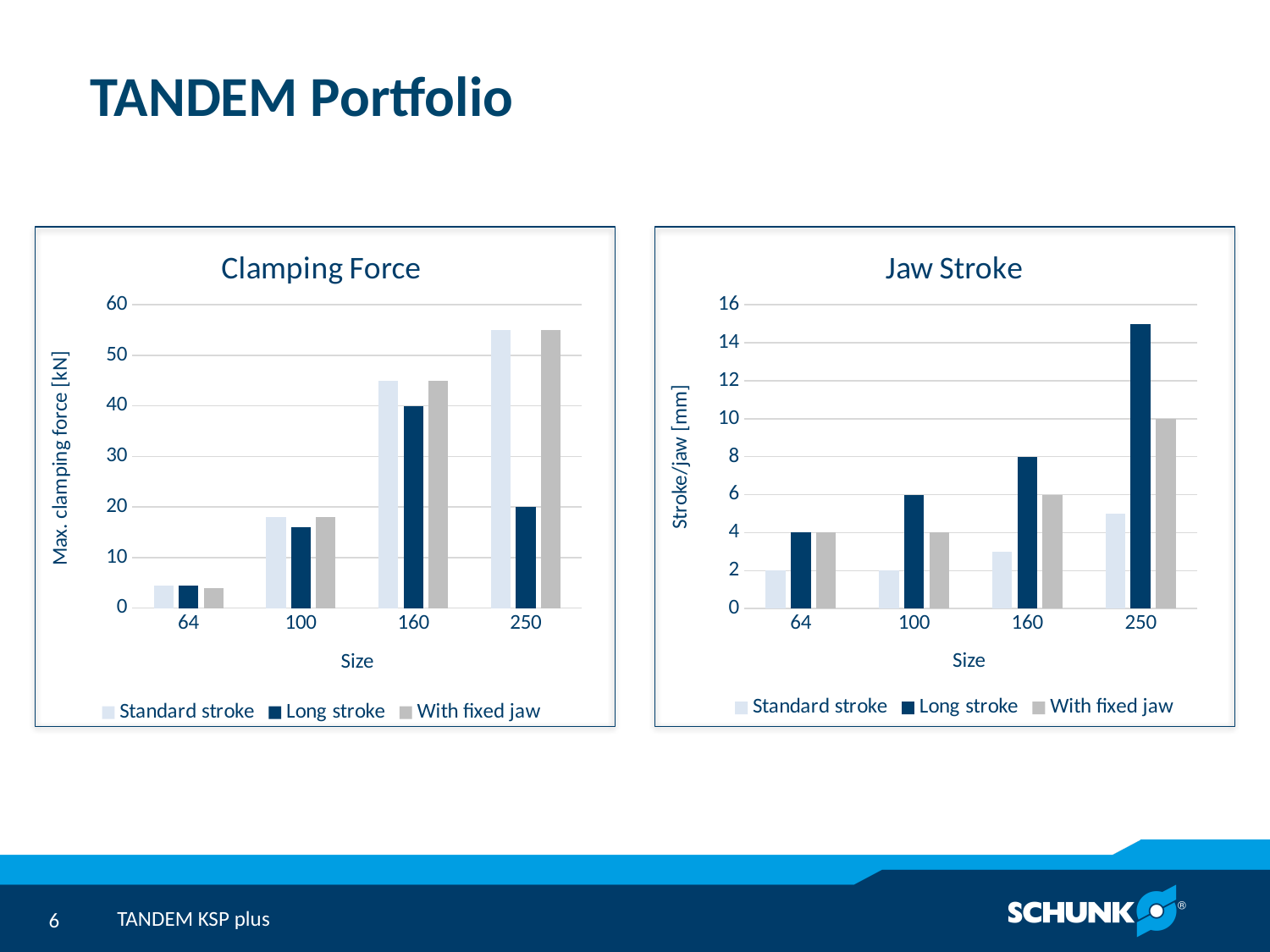
On the Clamping Force chart, for size 250, which is larger: Standard stroke or Long stroke? Standard stroke On the Clamping Force chart, what kind of chart is shown? bar chart On the Clamping Force chart, which size has the lowest With fixed jaw value? 64 On the Clamping Force chart, is the Long stroke value for size 250 greater or less than 30? less On the Clamping Force chart, is the Standard stroke value for size 250 greater or less than 50? greater On the Clamping Force chart, do the Standard stroke values rise or fall as size increases from 64 to 250? rise On the Jaw Stroke chart, how many series does the legend list? 3 On the Jaw Stroke chart, what is the Long stroke value for size 160? 8 On the Clamping Force chart, how many sizes are shown on the x axis? 4 On the Jaw Stroke chart, what is the With fixed jaw value for size 250? 10 On the Jaw Stroke chart, which size has the highest Long stroke value? 250 On the Jaw Stroke chart, what is the difference between the Long stroke and With fixed jaw values for size 160? 2